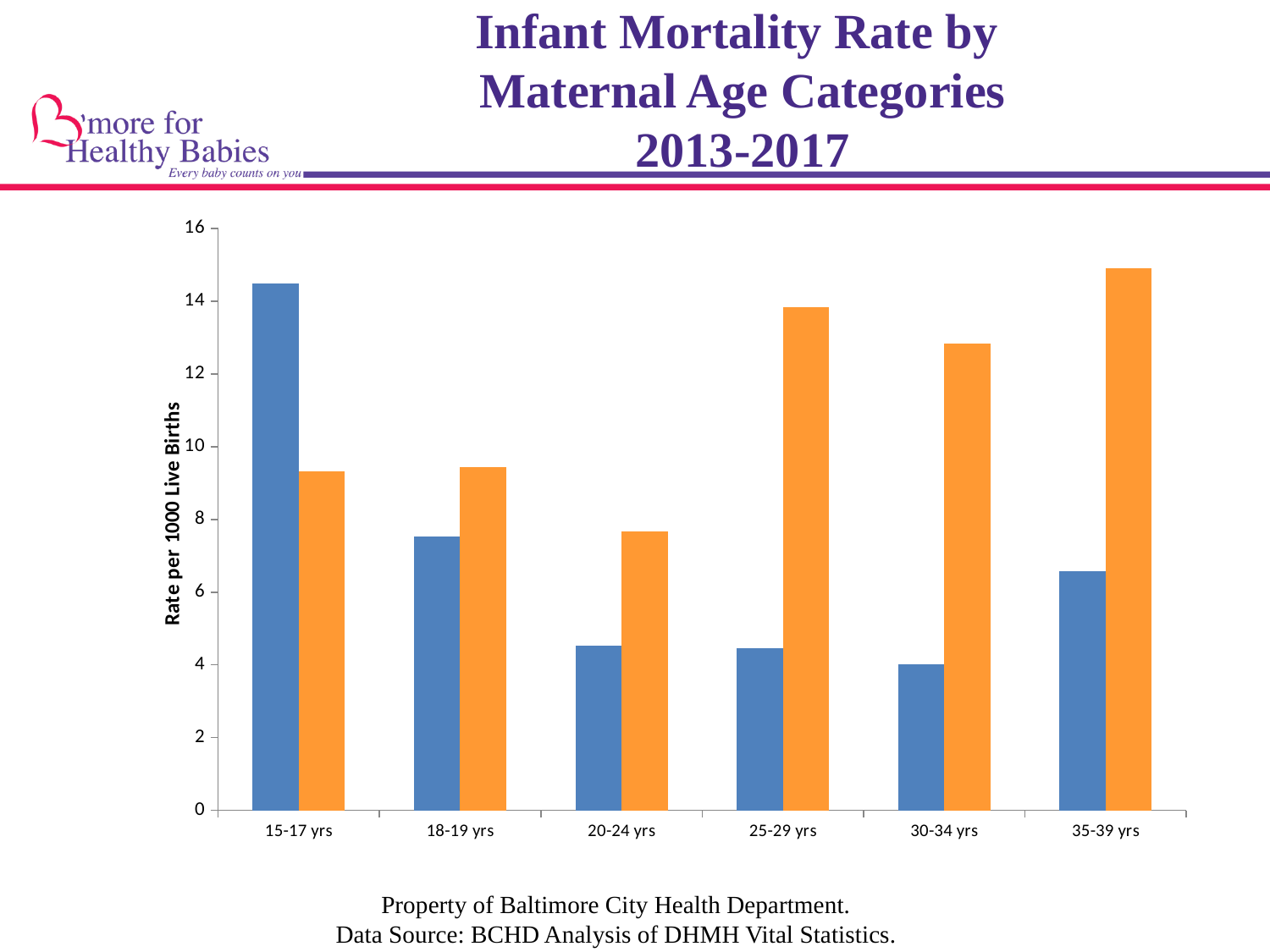
For the 25-29 yrs category, which bar is taller, the blue or the orange? Orange Which maternal age category has the tallest blue bar? 15-17 yrs Is the value of the blue bar for 15-17 yrs greater or less than 14? greater What kind of chart is shown on the slide? Bar chart Is the value of the blue bar for 30-34 yrs greater or less than 6? less For the 15-17 yrs category, which bar is taller, the blue or the orange? Blue What is the label on the vertical axis? Rate per 1000 Live Births How many maternal age categories are shown on the x axis? 6 Do the blue bars rise or fall from 15-17 yrs through 30-34 yrs? Fall Which maternal age category has the shortest orange bar? 20-24 yrs Which maternal age category has the tallest orange bar? 35-39 yrs